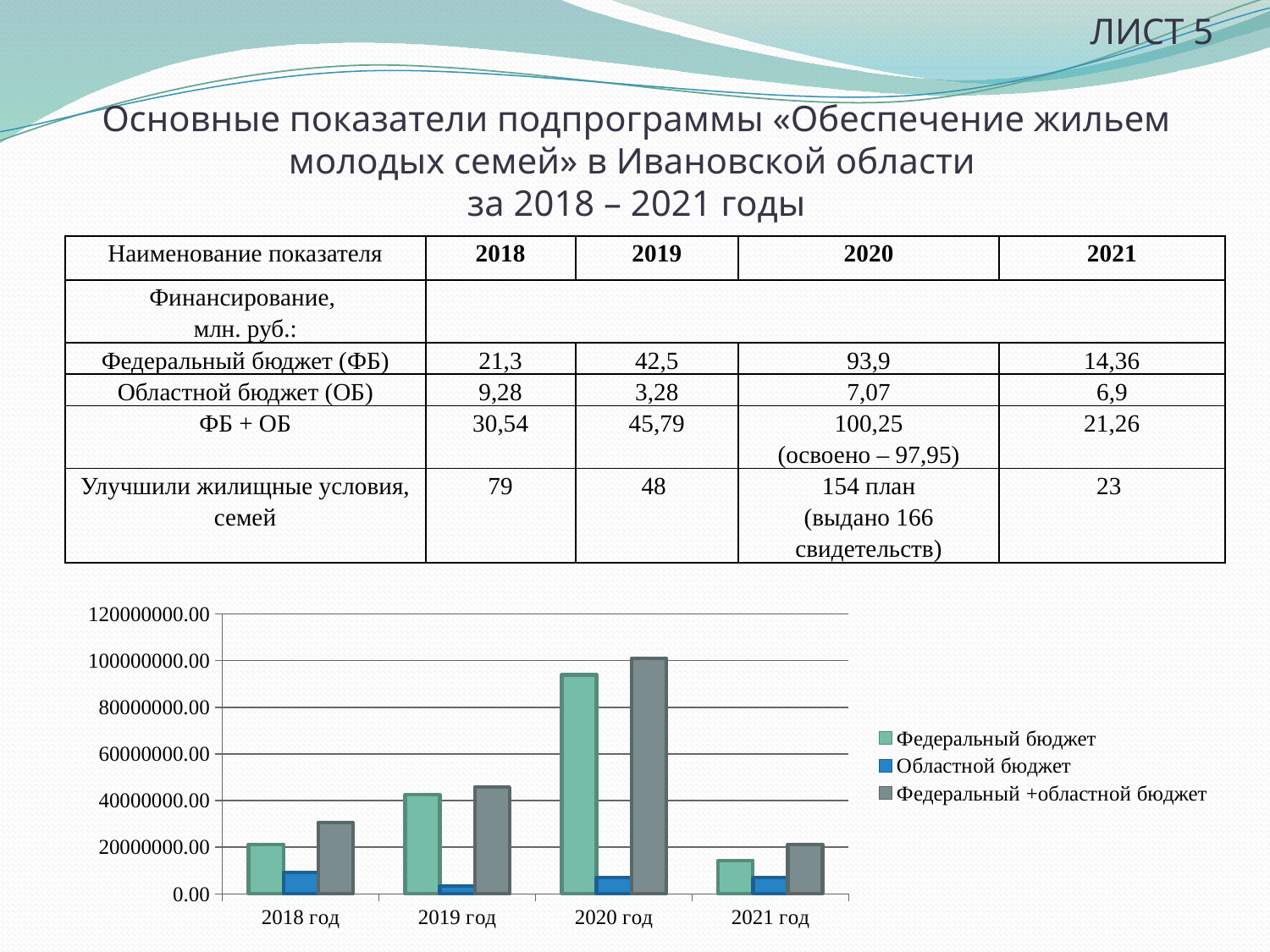
What colour represents Областной бюджет in the chart legend? blue Is the Федеральный бюджет value for 2020 год greater or less than 80000000.00? greater In which year is the Федеральный бюджет bar the lowest? 2021 год In which year is the Областной бюджет bar the lowest? 2019 год Is the Федеральный +областной бюджет value for 2021 год greater or less than 40000000.00? less How does the Федеральный +областной бюджет series change from 2018 год to 2021 год? rises through 2020, then falls in 2021 In which year is the Федеральный бюджет bar the highest? 2020 год How many year categories are shown on the x axis of the chart? 4 Is the Областной бюджет value for 2018 год greater or less than 20000000.00? less What kind of chart is shown at the bottom of the slide? bar chart How many series does the chart legend list? 3 Which is larger: the Федеральный бюджет bar for 2019 год or for 2021 год? 2019 год